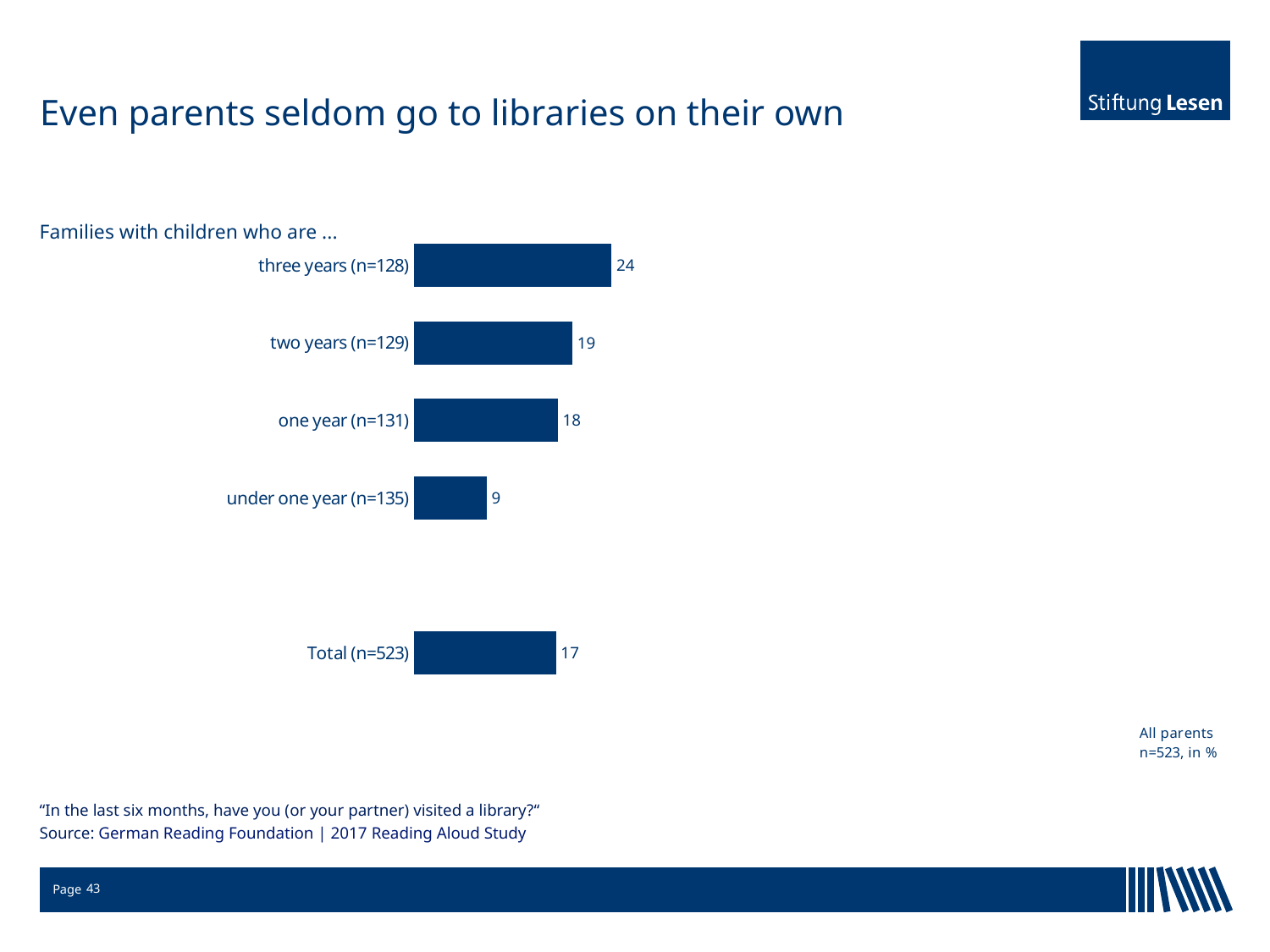
What is the title of the slide? Even parents seldom go to libraries on their own What is the value for families with children who are two years (n=129)? 19 What is the difference between the values for three years (n=128) and under one year (n=135)? 15 What is the value for families with children who are three years (n=128)? 24 What kind of chart is shown on the slide? bar chart Which category has the lowest value? under one year (n=135) Which is larger, the value for two years (n=129) or the value for Total (n=523)? two years (n=129) How many bars are shown in the chart? 5 What is the value for families with children under one year (n=135)? 9 Which category has the highest value? three years (n=128) What is the value for families with children who are one year (n=131)? 18 What is the value for Total (n=523)? 17